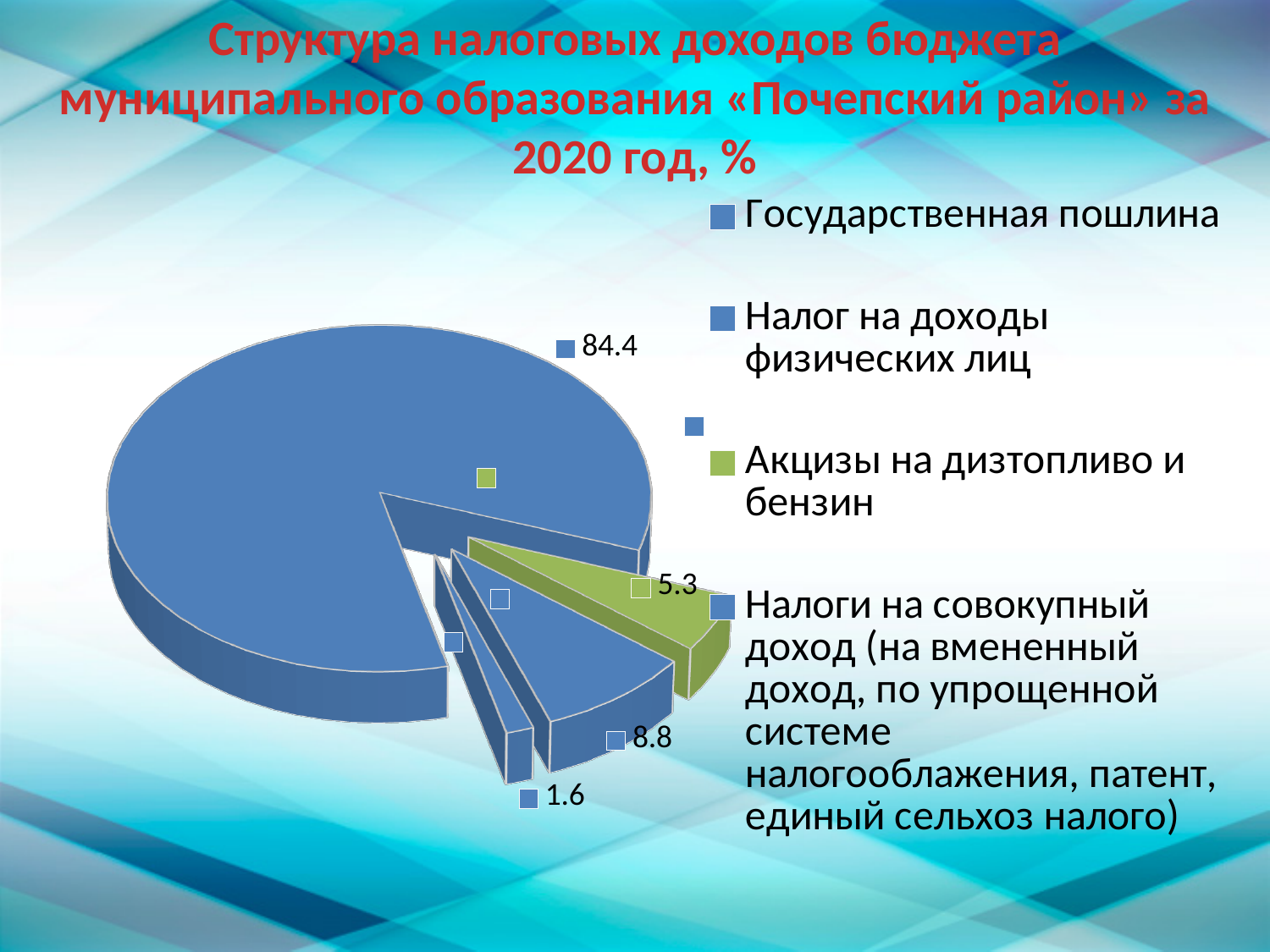
What kind of chart is shown on the slide? pie chart Which legend entry is shown in green? Акцизы на дизтопливо и бензин What is the smallest value labelled on the pie chart? 1.6 What is the difference between the largest slice (84.4) and the slice labelled 8.8? 75.6 What is the title of the chart? Структура налоговых доходов бюджета муниципального образования «Почепский район» за 2020 год, % What is the largest value labelled on the pie chart? 84.4 Which is larger: the slice labelled 8.8 or the slice for Акцизы на дизтопливо и бензин? the slice labelled 8.8 What value is shown for the green slice, Акцизы на дизтопливо и бензин? 5.3 How many slices with data labels does the pie chart have? 4 What is the difference between the slice labelled 8.8 and the slice for Акцизы на дизтопливо и бензин (5.3)? 3.5